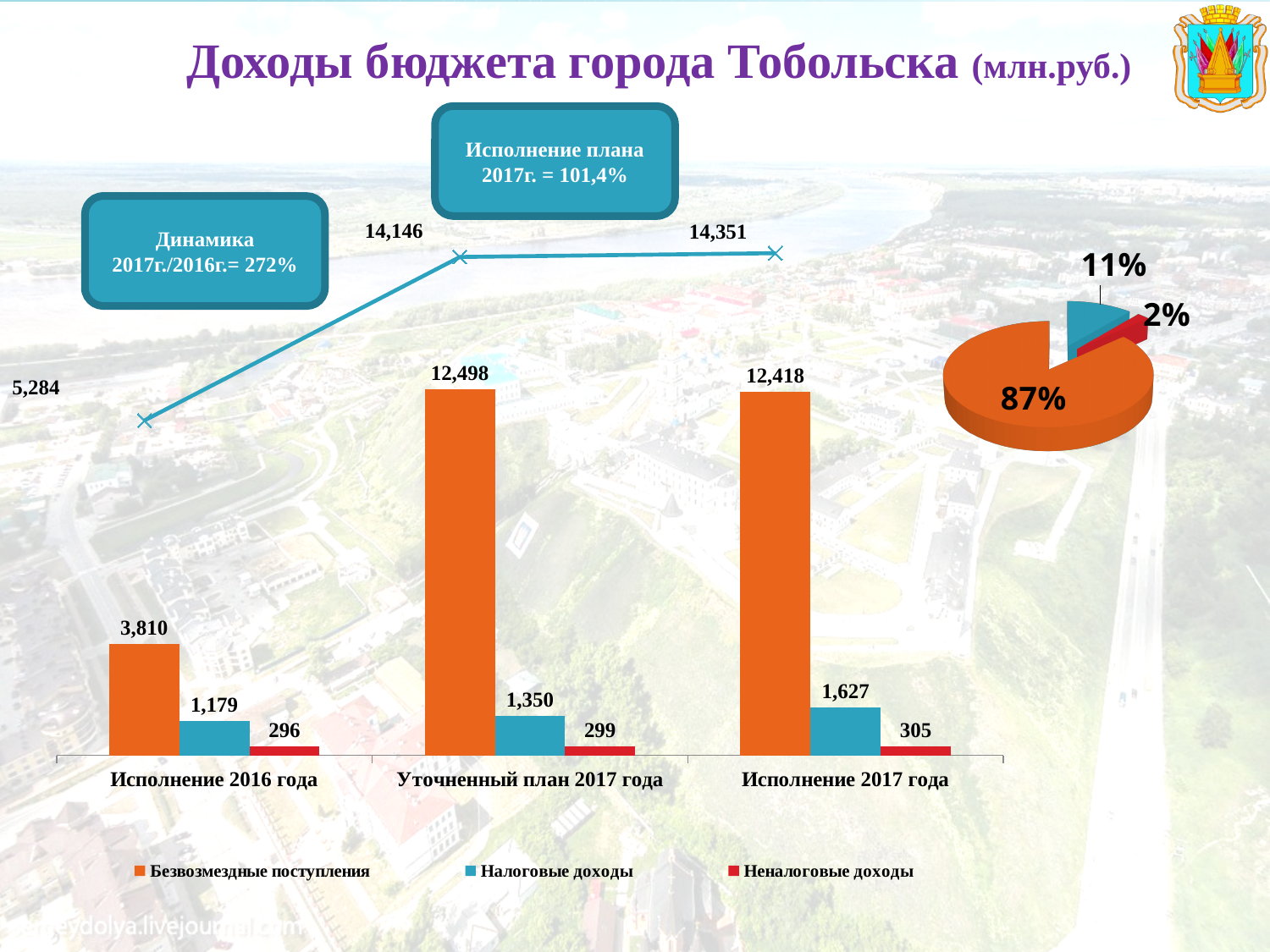
How many series does the bar chart legend list? 3 In the bar chart, which is larger: Безвозмездные поступления for Уточненный план 2017 года or for Исполнение 2017 года? Уточненный план 2017 года In the pie chart, what share does the largest slice have? 87% In the bar chart, which category has the highest value for Налоговые доходы? Исполнение 2017 года In the bar chart, what is the difference between Налоговые доходы for Исполнение 2017 года and for Уточненный план 2017 года? 277 What total value does the line show for Исполнение 2017 года? 14,351 What is the difference between the line values for Исполнение 2017 года and Уточненный план 2017 года? 205 In the bar chart, what is the value of Безвозмездные поступления for Исполнение 2017 года? 12,418 In the bar chart, what is the value of Неналоговые доходы for Исполнение 2016 года? 296 In the bar chart, which category has the lowest value for Безвозмездные поступления? Исполнение 2016 года How many categories are shown on the x axis of the bar chart? 3 In the bar chart, what is the value of Налоговые доходы for Уточненный план 2017 года? 1,350